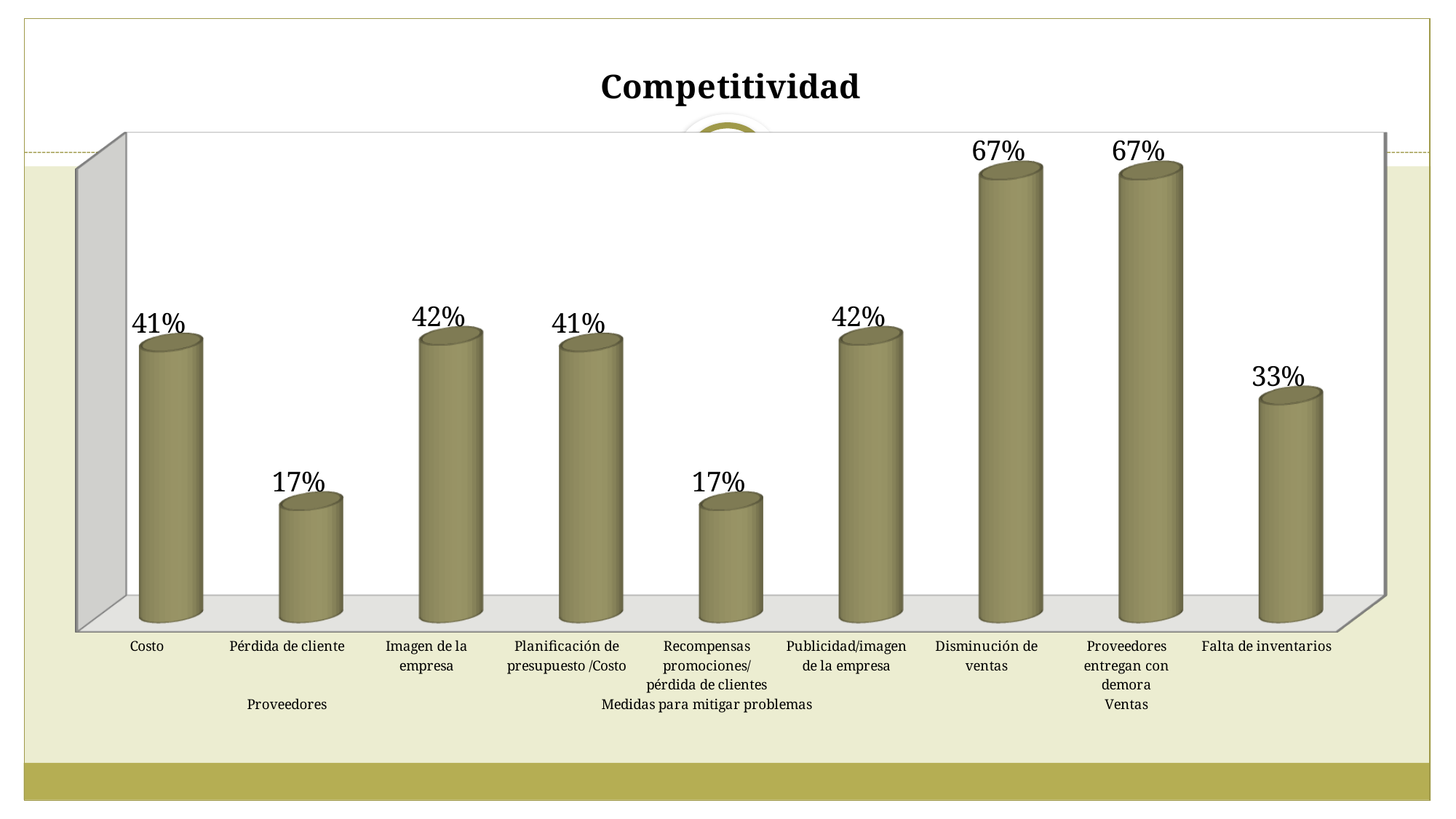
How many bars are shown in the chart? 9 What kind of chart is shown on the slide? Bar chart What is the value for Imagen de la empresa? 42% What is the value for Pérdida de cliente? 17% What is the difference between the values for Disminución de ventas and Falta de inventarios? 34% What is the lowest value shown in the chart? 17% What is the highest value shown in the chart? 67% What is the title of the chart? Competitividad What is the value for Falta de inventarios? 33% What is the value for Disminución de ventas? 67% What is the difference between the values for Costo and Pérdida de cliente? 24% Which is larger, the value for Proveedores entregan con demora or the value for Publicidad/imagen de la empresa? Proveedores entregan con demora